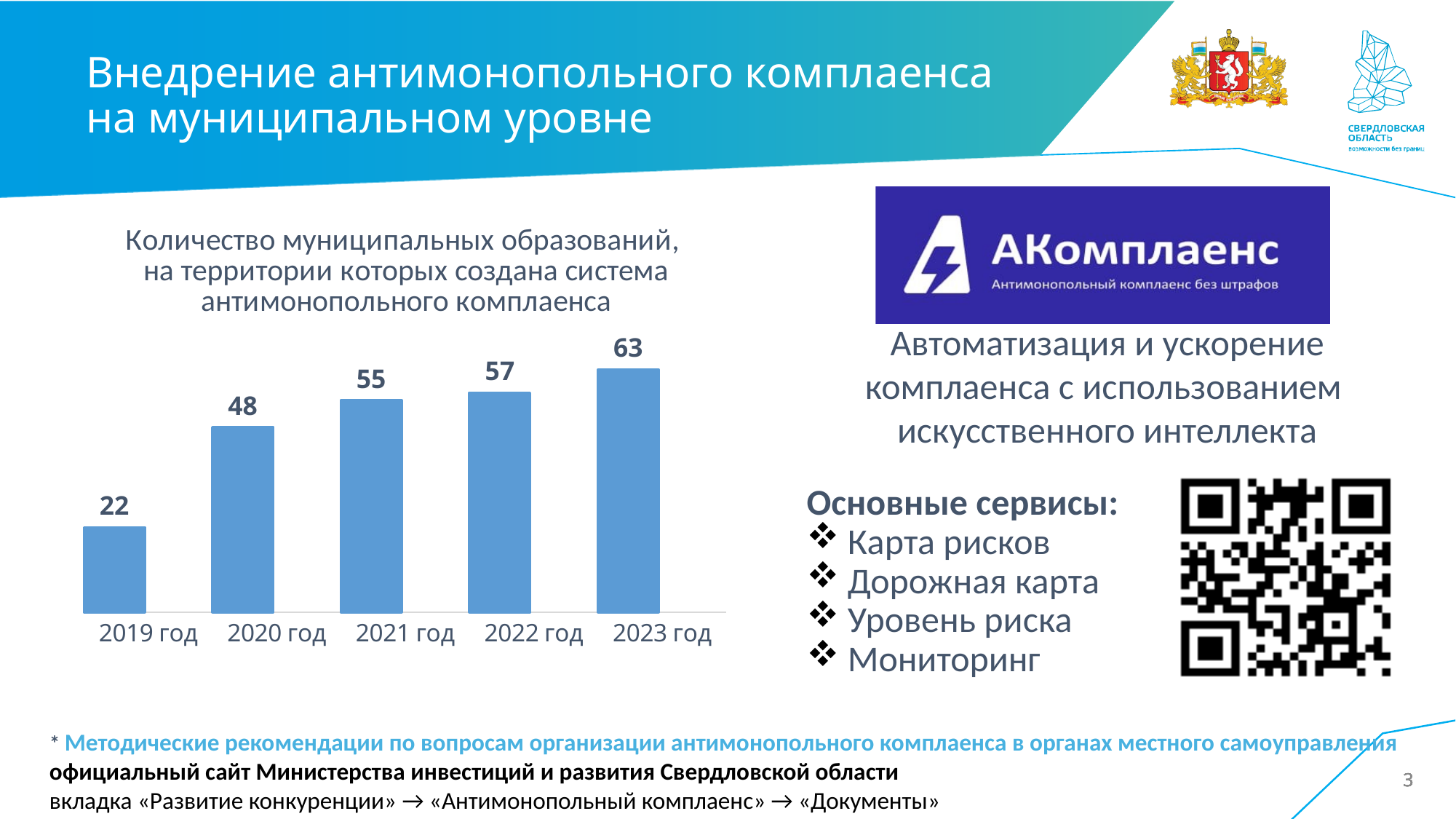
What is the difference between the values for 2020 год and 2019 год? 26 Do the values rise or fall from 2019 год to 2023 год? rise What kind of chart is shown on the slide? bar chart What is the value for 2019 год? 22 What is the value for 2023 год? 63 What is the title of the chart? Количество муниципальных образований, на территории которых создана система антимонопольного комплаенса What is the difference between the values for 2023 год and 2022 год? 6 Which year has the lowest value? 2019 год Which is larger, the value for 2021 год or the value for 2022 год? 2022 год How many years are shown on the x axis of the chart? 5 Which year has the highest value? 2023 год What is the value for 2021 год? 55